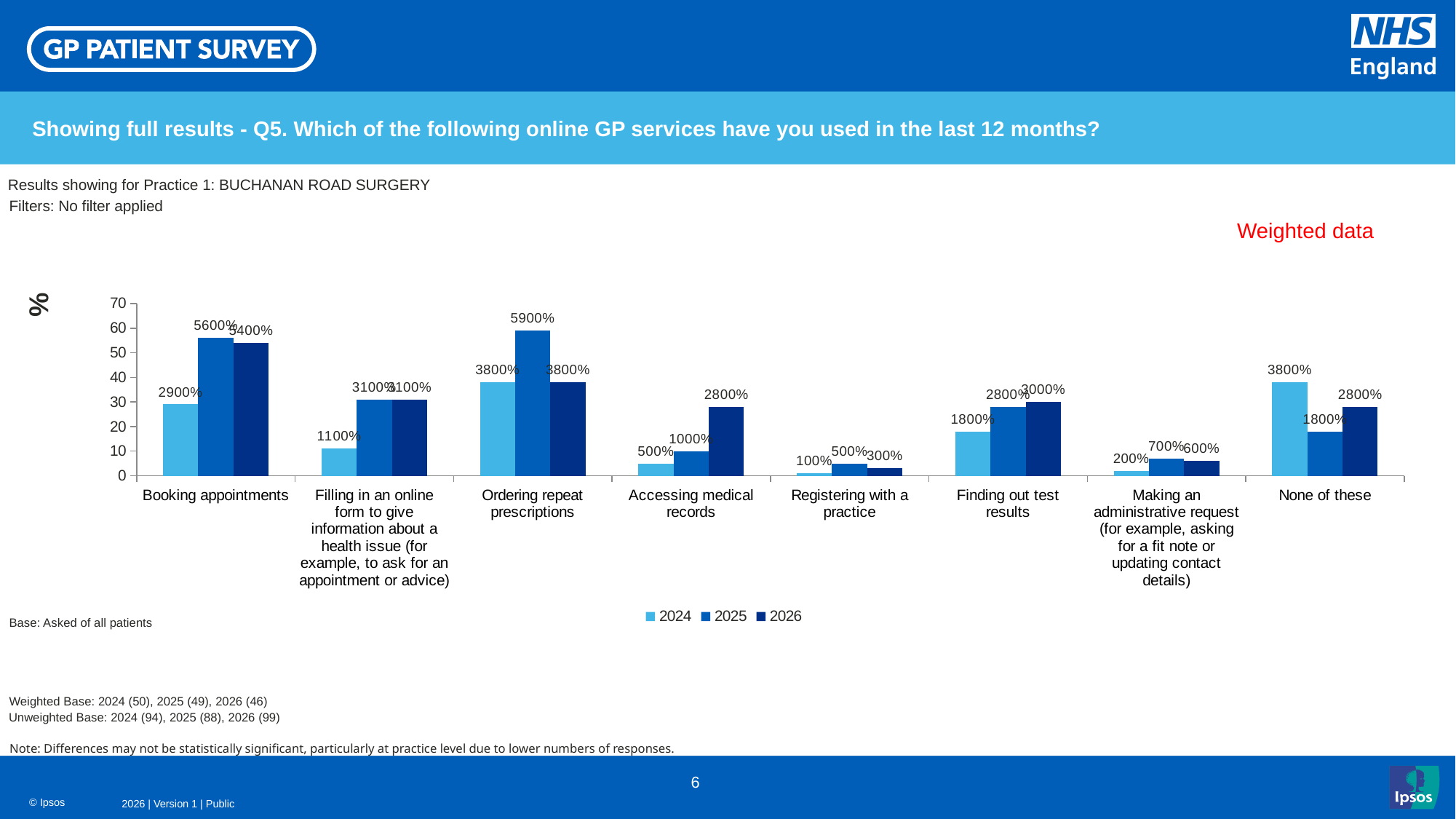
What kind of chart is shown on the slide? Bar chart What is the 2024 value for None of these? 3800% How many series does the legend list? 3 What is the difference between the 2025 and 2024 values for Booking appointments? 2700% How many categories are shown on the x axis? 8 What is the 2025 value for Ordering repeat prescriptions? 5900% What is the 2026 value for Accessing medical records? 2800% What is the 2024 value for Booking appointments? 2900% Which series does the lightest blue colour represent in the legend? 2024 Which is larger for Finding out test results, the 2024 value or the 2026 value? 2026 Which category has the lowest 2024 value? Registering with a practice Which category has the highest 2025 value? Ordering repeat prescriptions